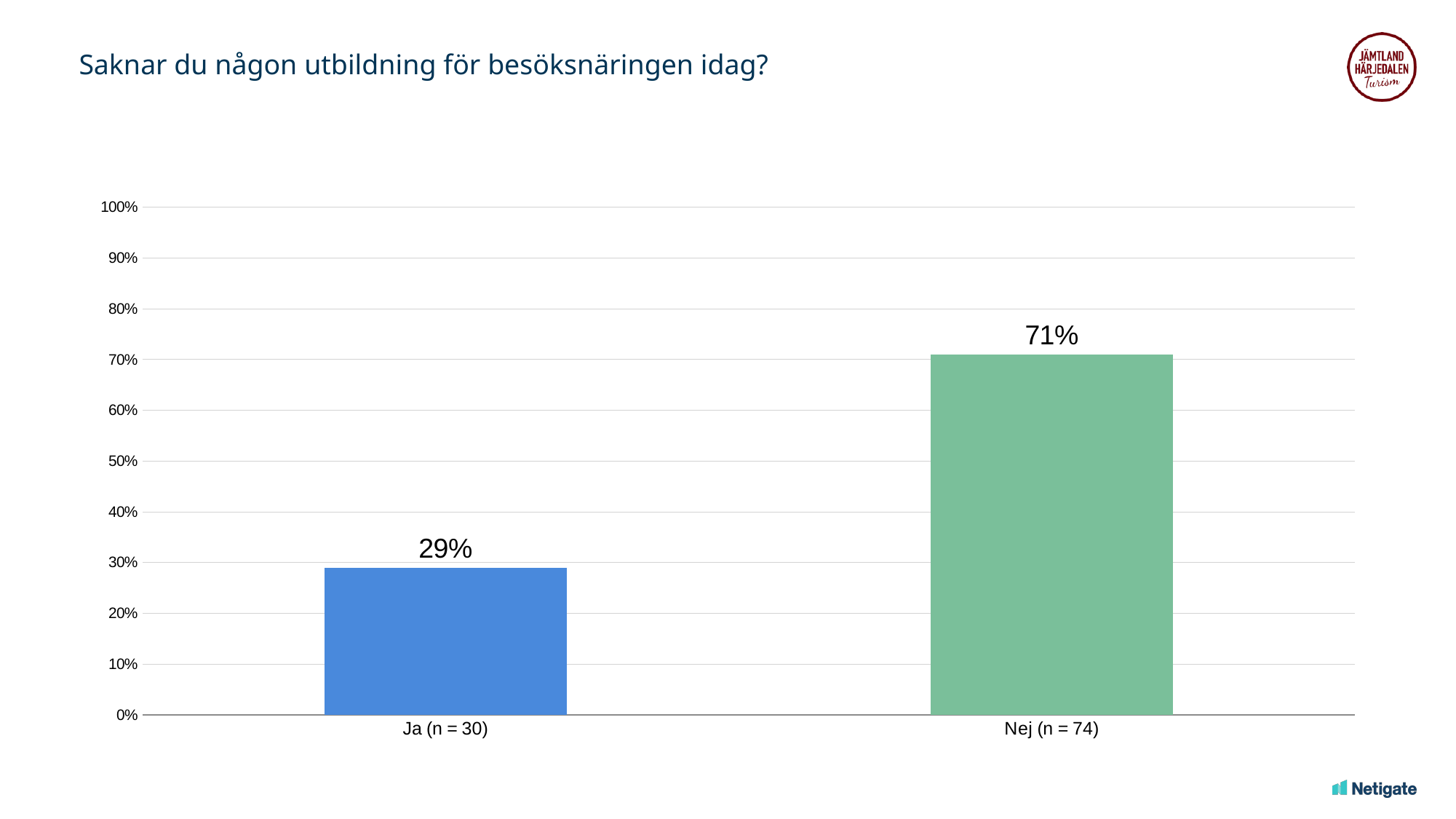
What is the title of the slide? Saknar du någon utbildning för besöksnäringen idag? Which category has the lowest value? Ja (n = 30) Which category has the highest value? Nej (n = 74) What is the difference between the values for Nej (n = 74) and Ja (n = 30)? 42% What kind of chart is shown on the slide? bar chart What is the value for Nej (n = 74)? 71% Is the value for Ja (n = 30) greater or less than 40%? less What is the value for Ja (n = 30)? 29% How many categories are shown on the x axis? 2 Which is larger, the value for Ja (n = 30) or the value for Nej (n = 74)? Nej (n = 74) Is the value for Nej (n = 74) greater or less than 50%? greater What is the highest value shown on the y axis? 100%